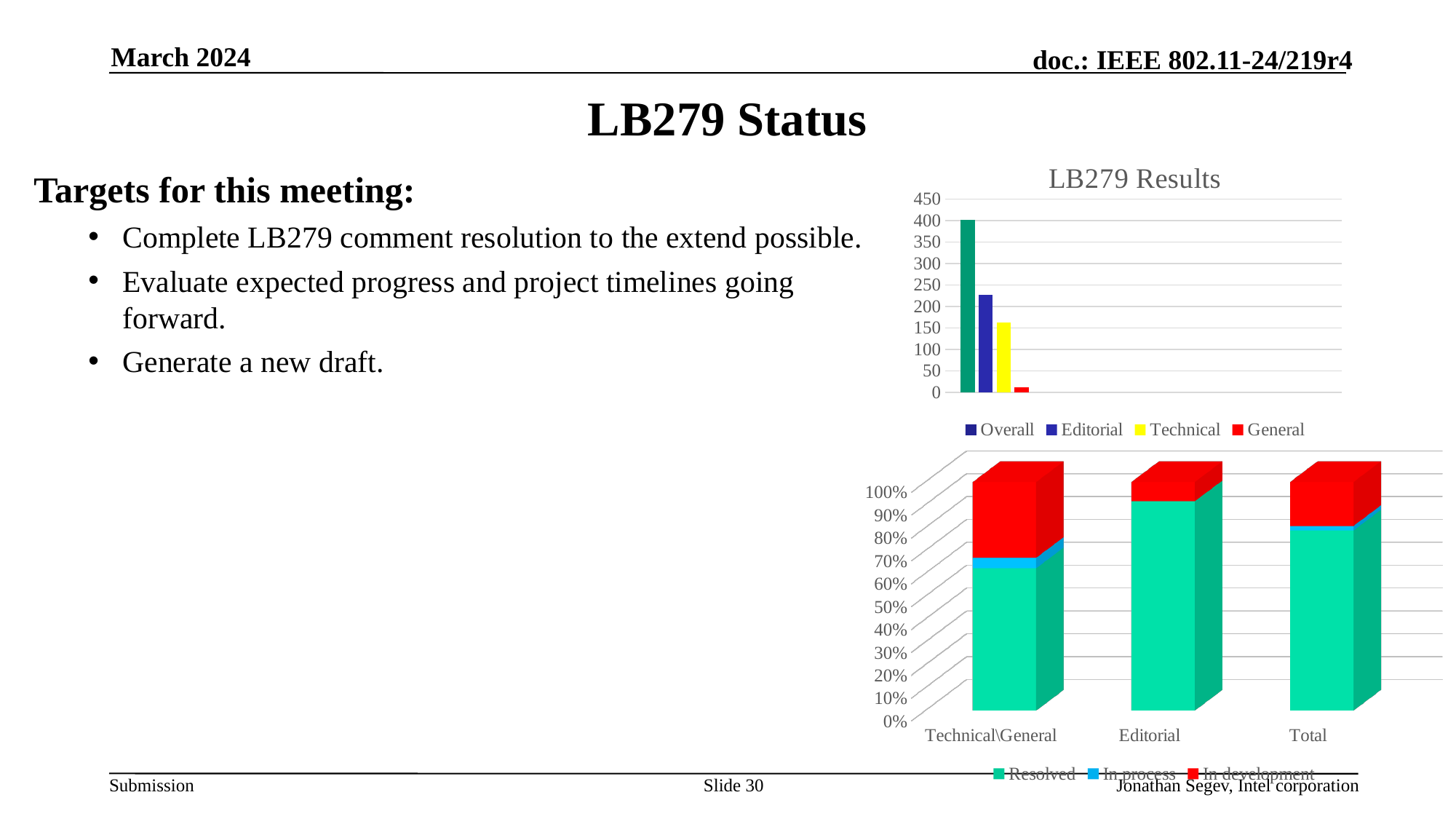
In the bottom stacked bar chart, which category has the largest Resolved share? Editorial In the bottom stacked bar chart, is the Resolved share for Technical\General greater or less than 80%? less In the LB279 Results chart, which series has the shortest bar? General In the LB279 Results chart, is the value for Overall greater or less than 350? greater In the LB279 Results chart, is the value for Technical greater or less than 200? less In the LB279 Results chart, what type of chart is shown? bar chart In the bottom stacked bar chart, how many series does the legend list? 3 In the bottom stacked bar chart, how many categories are shown on the x axis? 3 In the LB279 Results chart, which is larger, Editorial or Technical? Editorial In the LB279 Results chart, which series has the tallest bar? Overall In the LB279 Results chart, how many series does the legend list? 4